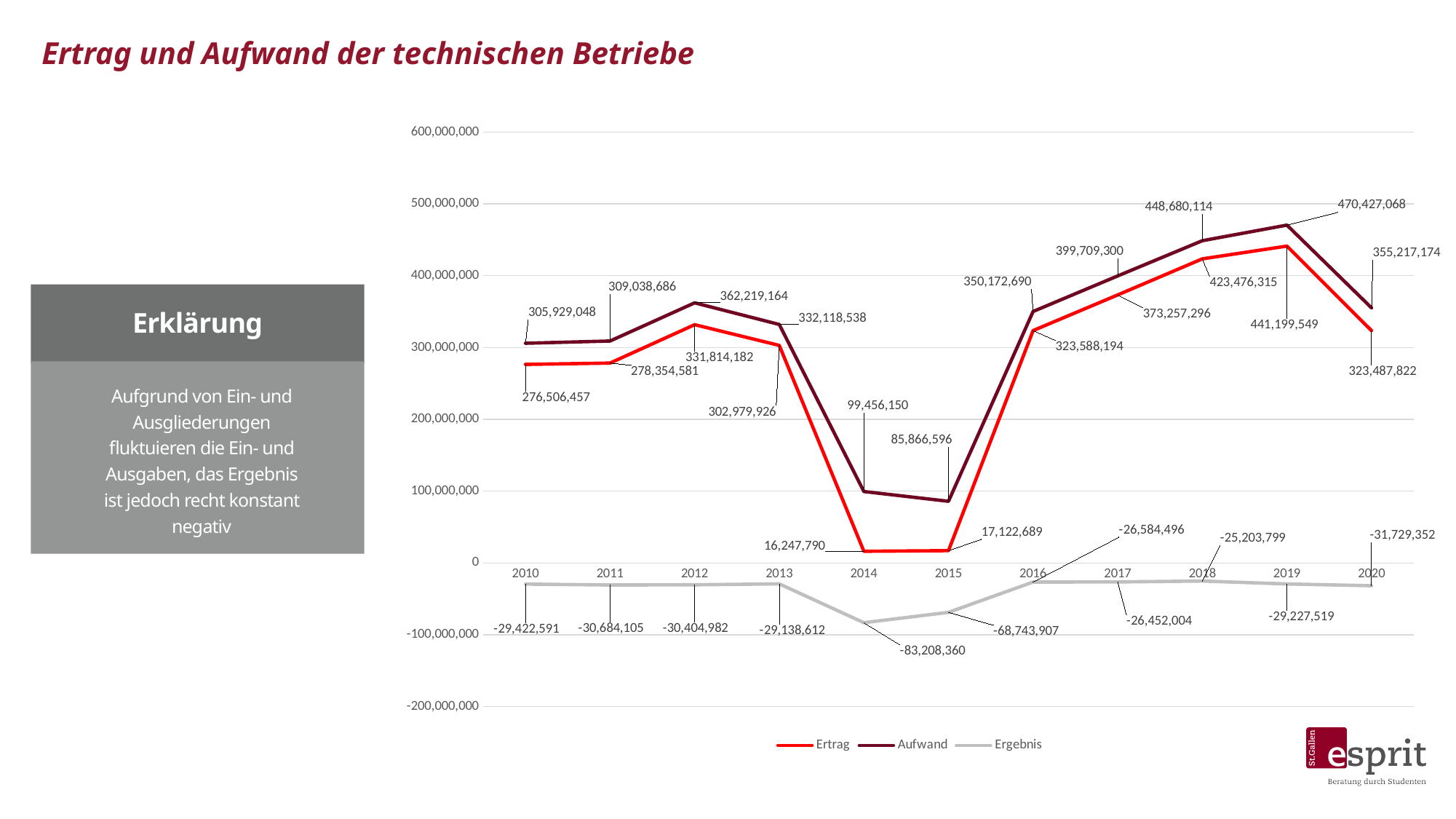
In which year is Ergebnis lowest? 2014 What is the Ergebnis value for 2015? -68,743,907 Is the Ertrag value for 2016 greater or less than 300,000,000? greater Which is larger, Aufwand in 2012 or Aufwand in 2013? Aufwand in 2012 How many series does the legend list? 3 By how much did Ertrag increase from 2017 to 2018? 50,219,019 What is the Ertrag value for 2014? 16,247,790 What is the difference between Aufwand and Ertrag in 2019? 29,227,519 What is the Aufwand value for 2019? 470,427,068 What kind of chart is shown on the slide? Line chart In which year is Aufwand highest? 2019 How many years are shown on the x axis? 11